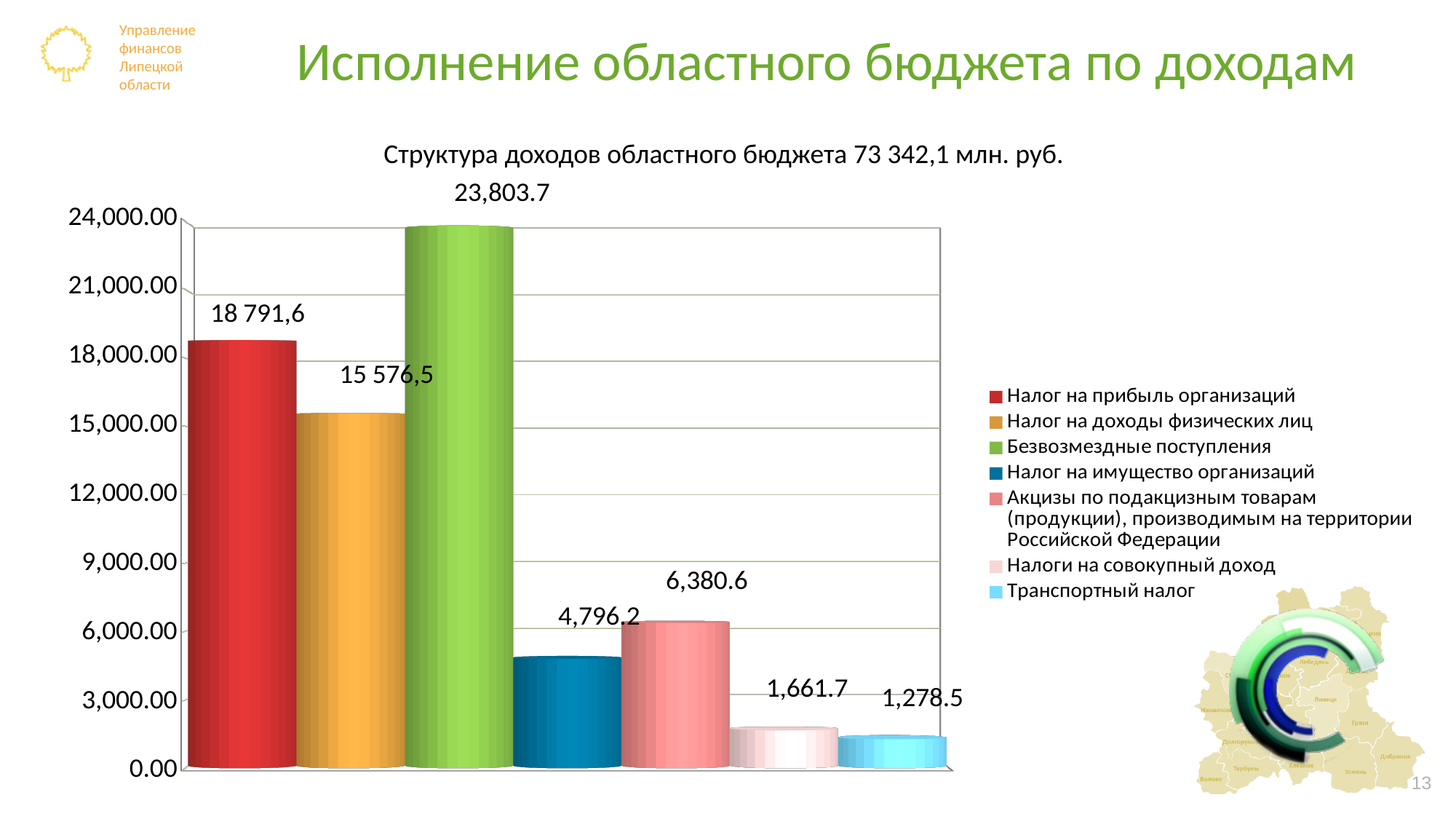
Which category has the lowest value? Транспортный налог Which is larger: Налог на доходы физических лиц or Налог на прибыль организаций? Налог на прибыль организаций What is the value for Налог на имущество организаций? 4,796.2 Which category has the highest value? Безвозмездные поступления Is the value for Налоги на совокупный доход greater or less than 3,000.00? less What type of chart is shown on the slide? bar chart What is the value for Налог на прибыль организаций? 18 791,6 What is the value for Транспортный налог? 1,278.5 How many entries does the legend list? 7 What is the value for Безвозмездные поступления? 23,803.7 How many bars are plotted in the chart? 7 What is the difference between the values for Акцизы по подакцизным товарам and Налог на имущество организаций? 1,584.4